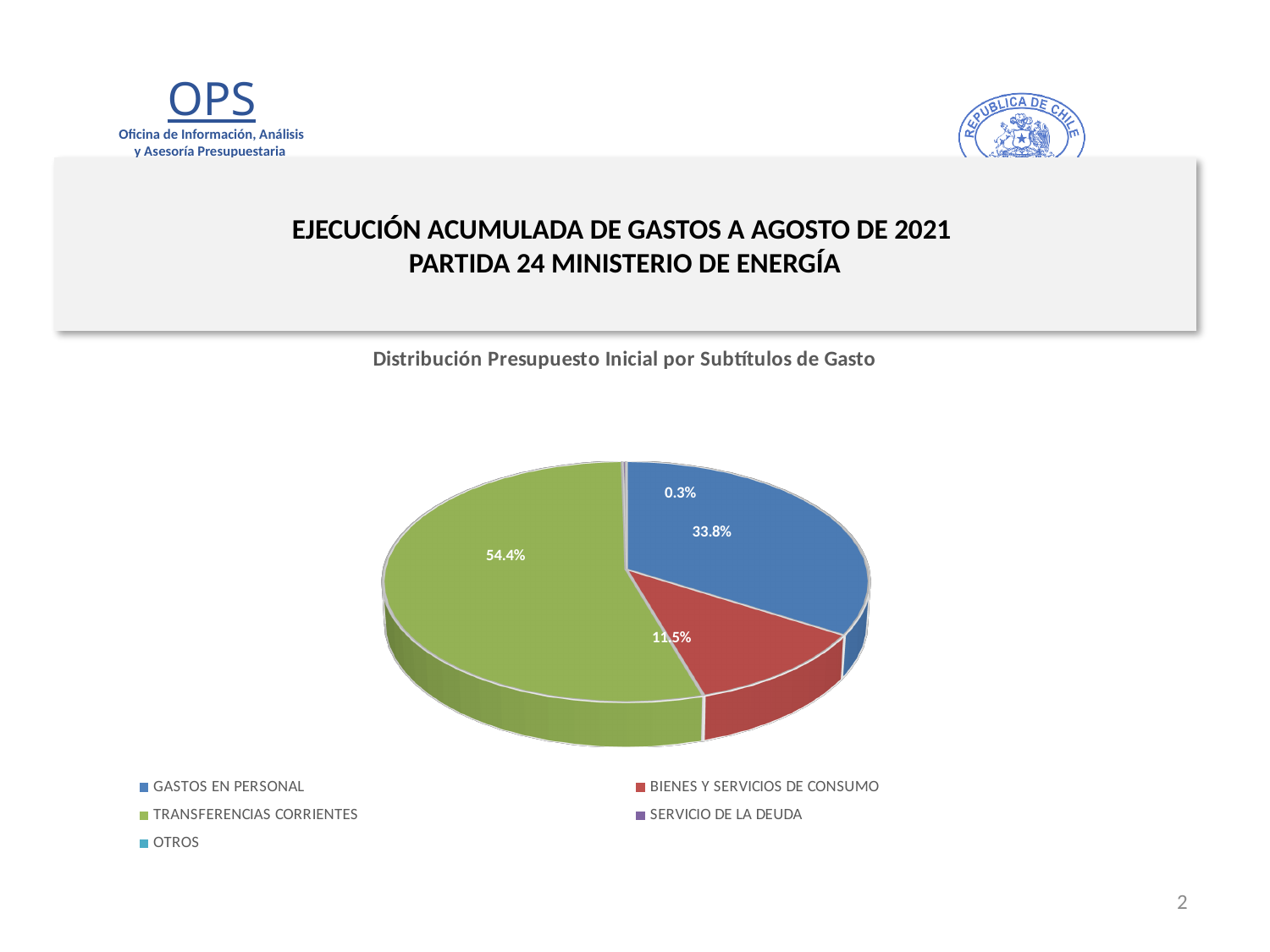
What is the smallest percentage labelled on the pie? 0.3% Which category has the largest slice of the pie? TRANSFERENCIAS CORRIENTES What colour is the TRANSFERENCIAS CORRIENTES slice? Green What share of the pie does GASTOS EN PERSONAL represent? 33.8% What is the difference between the shares of GASTOS EN PERSONAL and BIENES Y SERVICIOS DE CONSUMO? 22.3 percentage points How many categories does the legend list? 5 What share of the pie does TRANSFERENCIAS CORRIENTES represent? 54.4% What kind of chart is shown on the slide? Pie chart What share of the pie does BIENES Y SERVICIOS DE CONSUMO represent? 11.5% Which is larger, the share for GASTOS EN PERSONAL or the share for BIENES Y SERVICIOS DE CONSUMO? GASTOS EN PERSONAL What is the title of the chart? Distribución Presupuesto Inicial por Subtítulos de Gasto By how many percentage points does TRANSFERENCIAS CORRIENTES exceed GASTOS EN PERSONAL? 20.6 percentage points